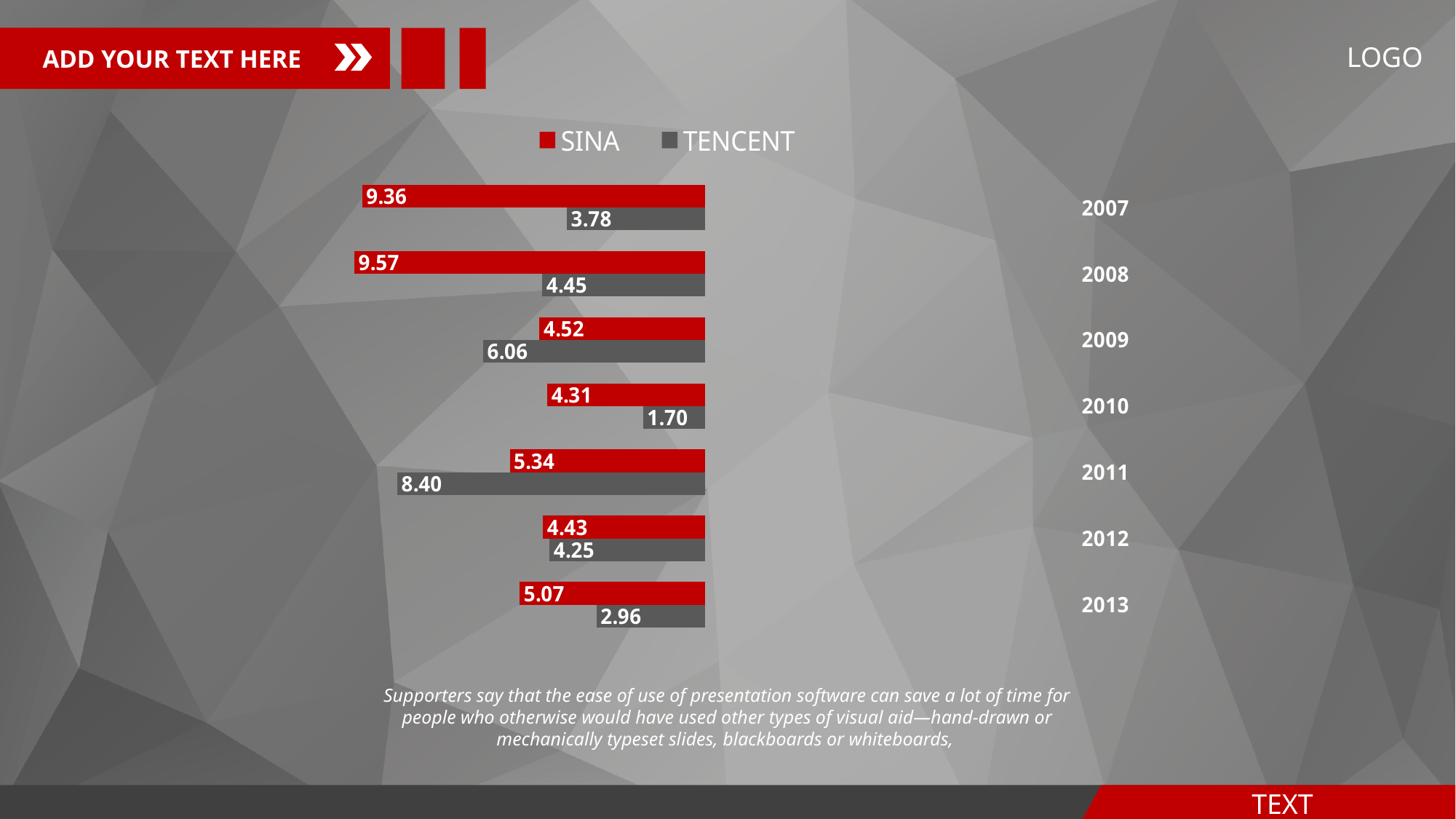
What is the difference between the SINA and TENCENT values in 2007? 5.58 Which year has the lowest TENCENT value? 2010 Which colour represents SINA in the legend? Red What kind of chart is shown on the slide? Bar chart What is the TENCENT value for 2010? 1.70 Which is larger in 2009, the SINA value or the TENCENT value? TENCENT What is the difference between the TENCENT values for 2011 and 2013? 5.44 How many years are shown on the chart? 7 How many series does the legend list? 2 What is the SINA value for 2007? 9.36 What is the TENCENT value for 2011? 8.40 Which year has the highest SINA value? 2008